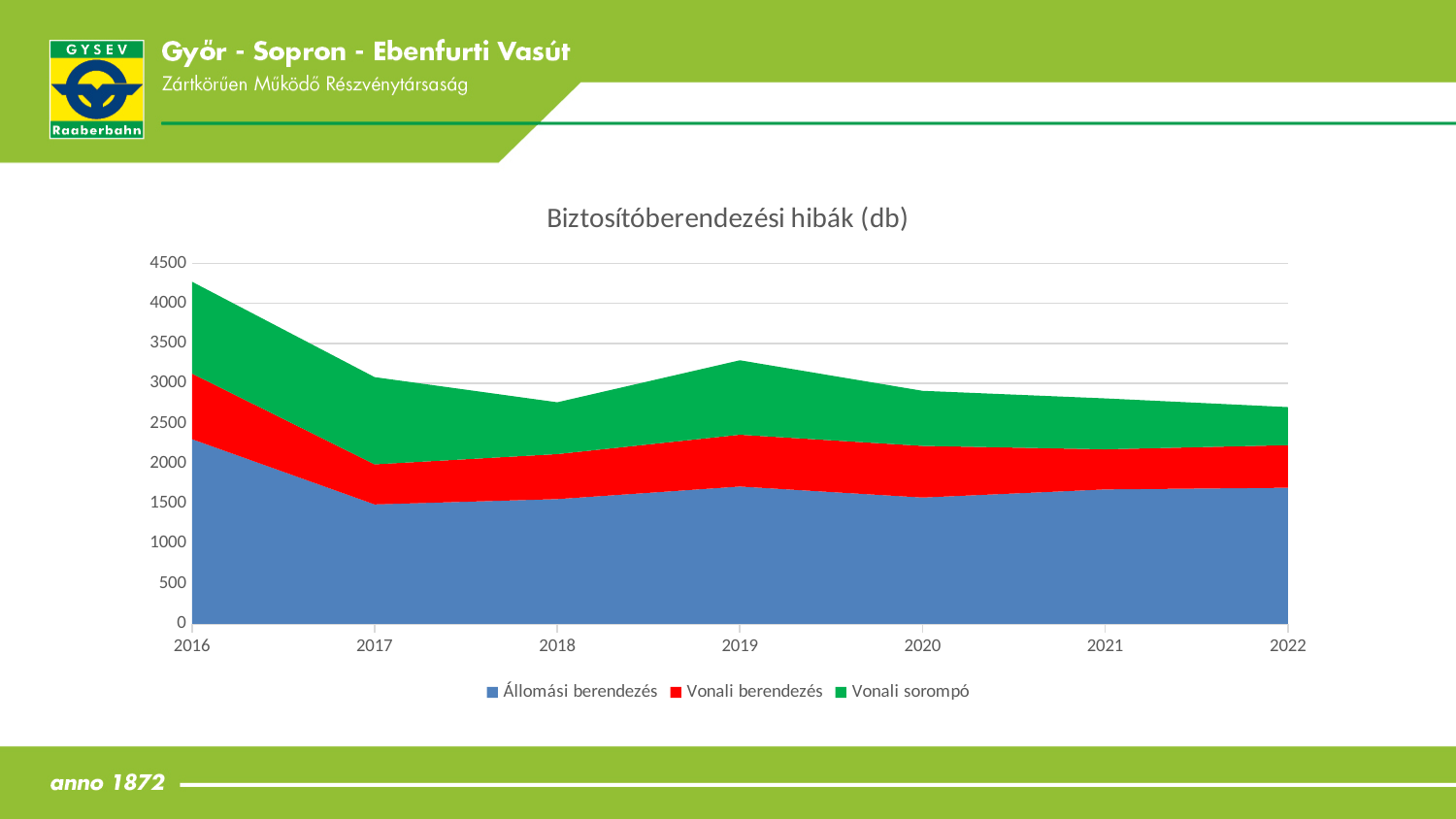
Which series is shown in green in the legend? Vonali sorompó Does the total number of errors rise or fall from 2016 to 2017? fall What is the title of the chart? Biztosítóberendezési hibák (db) Is the value for Állomási berendezés in 2016 greater or less than 2000? greater In which year is the total number of errors (top of the stacked area) highest? 2016 Is the value for Állomási berendezés in 2017 greater or less than 2000? less How many years are plotted along the x axis? 7 Is the total value for 2022 greater or less than 3000? less What kind of chart is shown on the slide? Stacked area chart How many series does the legend list? 3 In 2016, which is larger: the Állomási berendezés value or the Vonali berendezés value? Állomási berendezés